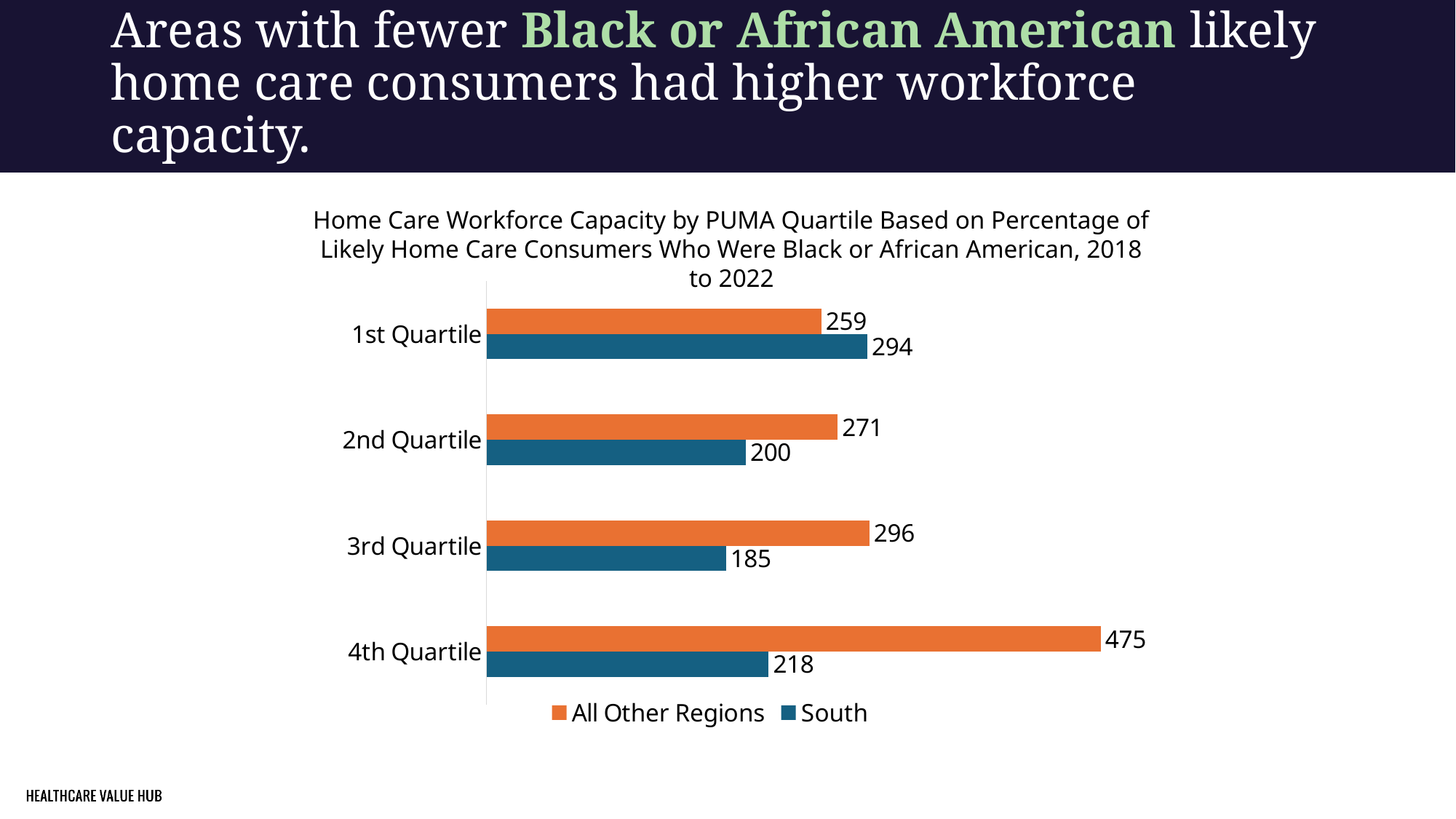
What is the home care workforce capacity for the South in the 1st Quartile? 294 What is the difference between All Other Regions and South in the 4th Quartile? 257 What is the home care workforce capacity for All Other Regions in the 4th Quartile? 475 How many quartile categories are shown on the chart? 4 Which quartile has the lowest value for the South? 3rd Quartile How many series does the legend list? 2 What is the value for the South in the 3rd Quartile? 185 Which quartile has the highest value for All Other Regions? 4th Quartile Which colour represents the South series in the chart? Blue In the 1st Quartile, which series has the larger value, All Other Regions or South? South What is the difference between the South values in the 1st Quartile and the 2nd Quartile? 94 What kind of chart is shown on the slide? Bar chart